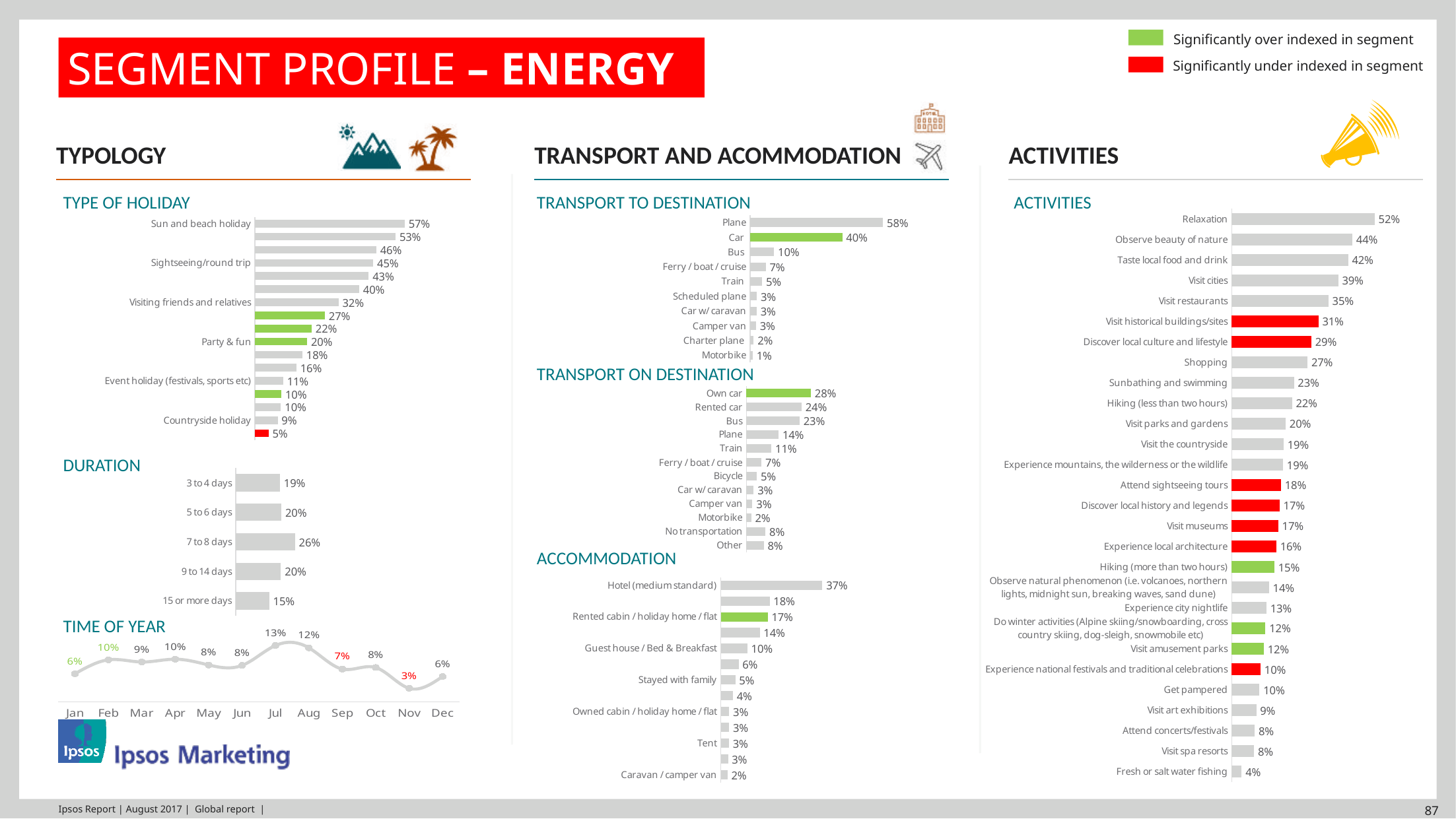
In the Transport to Destination chart, which category has the highest value? Plane In the Accommodation chart, what is the value for Hotel (medium standard)? 37% In the Activities chart, what is the value for Visit historical buildings/sites? 31% In the Time of Year chart, what is the value for Nov? 3% In the Duration chart, how many categories are shown? 5 In the Activities chart, which activity has the lowest value? Fresh or salt water fishing In the Transport on Destination chart, which is larger, Rented car or Bus? Rented car In the Duration chart, which duration has the highest value? 7 to 8 days In the Transport to Destination chart, what is the difference between Plane and Car? 18% In the Transport to Destination chart, what is the value for Car? 40% In the Time of Year chart, which month has the highest value? Jul What kind of chart is the Time of Year chart? Line chart